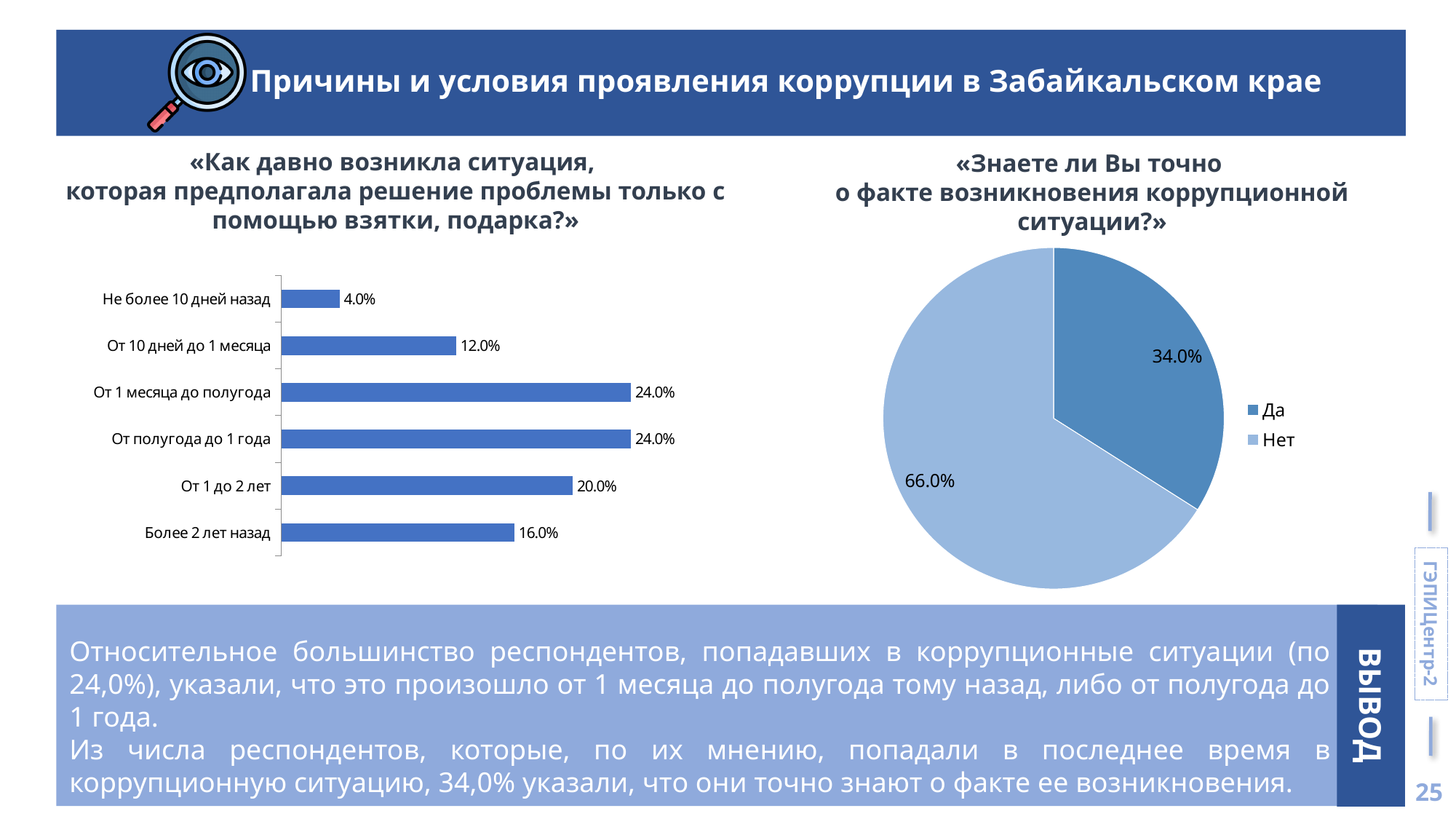
How many entries does the legend of the right pie chart list? 2 In the left bar chart («Как давно возникла ситуация...»), what is the value for «От 1 до 2 лет»? 20.0% In the right pie chart («Знаете ли Вы точно о факте возникновения коррупционной ситуации?»), what share is «Нет»? 66.0% What type of chart is the left chart («Как давно возникла ситуация...»)? Bar chart In the left bar chart («Как давно возникла ситуация...»), which category has the lowest value? Не более 10 дней назад What type of chart is the right chart («Знаете ли Вы точно о факте возникновения коррупционной ситуации?»)? Pie chart In the right pie chart («Знаете ли Вы точно о факте возникновения коррупционной ситуации?»), what share is «Да»? 34.0% In the left bar chart («Как давно возникла ситуация...»), which is larger: «Более 2 лет назад» or «От 1 до 2 лет»? От 1 до 2 лет How many categories are shown in the left bar chart («Как давно возникла ситуация...»)? 6 In the right pie chart («Знаете ли Вы точно о факте возникновения коррупционной ситуации?»), which slice is the largest? Нет In the left bar chart («Как давно возникла ситуация...»), what is the value for «Не более 10 дней назад»? 4.0% In the left bar chart («Как давно возникла ситуация...»), what is the difference between «От 1 месяца до полугода» and «От 10 дней до 1 месяца»? 12.0%